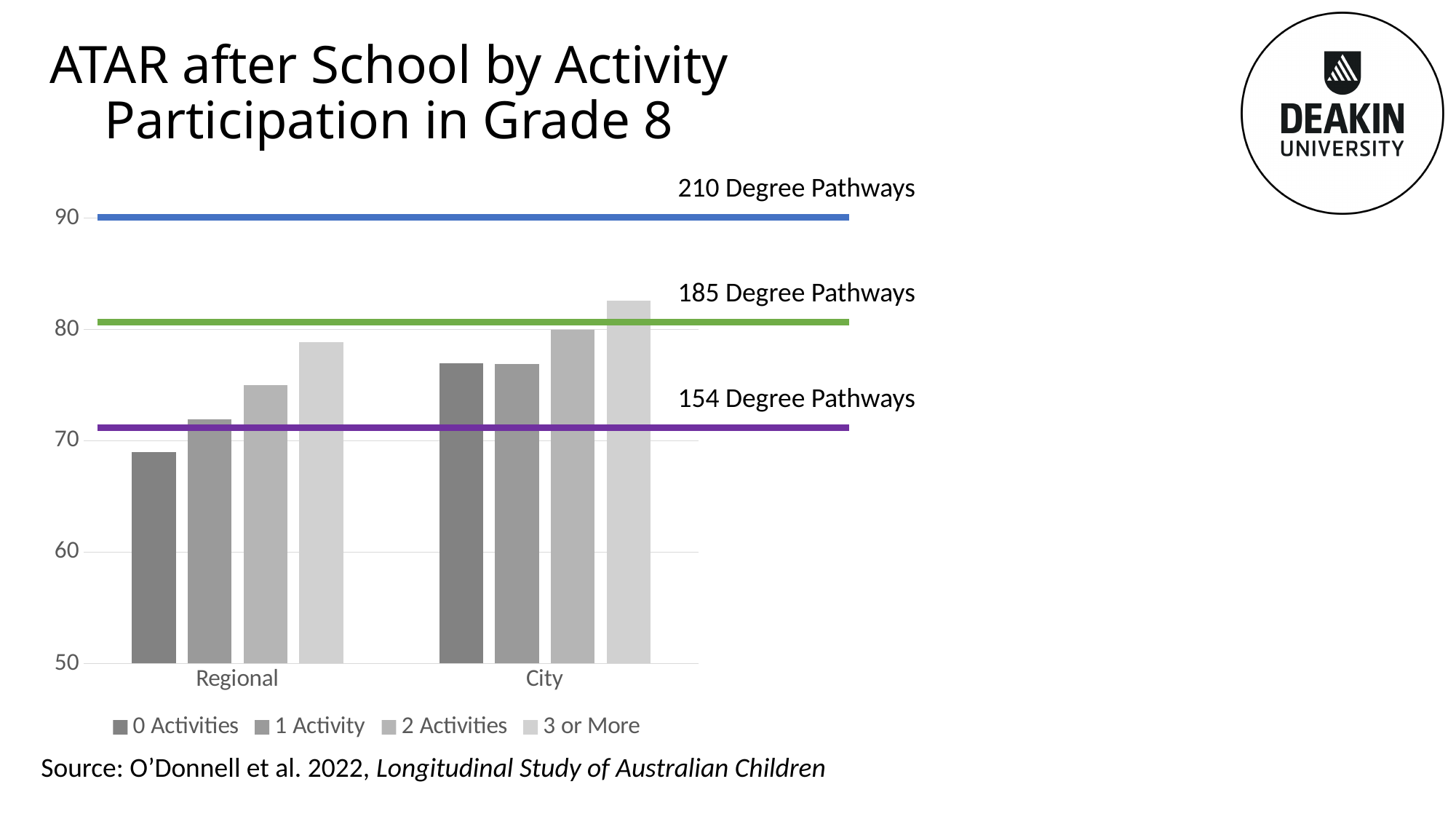
How many series does the legend list? 4 How many categories are shown on the x axis? 2 Which bar is the tallest in the chart? 3 or More, City Is the value for 3 or More in the City category greater or less than 80? greater What is the label of the topmost horizontal reference line on the chart? 210 Degree Pathways Is the value for 0 Activities in the City category greater or less than 70? greater Is the value for 0 Activities in the Regional category greater or less than 70? less What kind of chart is shown on the slide? bar chart In the Regional category, which is larger: 0 Activities or 3 or More? 3 or More In the Regional category, do the bars rise or fall as the number of activities increases from 0 Activities to 3 or More? rise Which bar is the shortest in the chart? 0 Activities, Regional